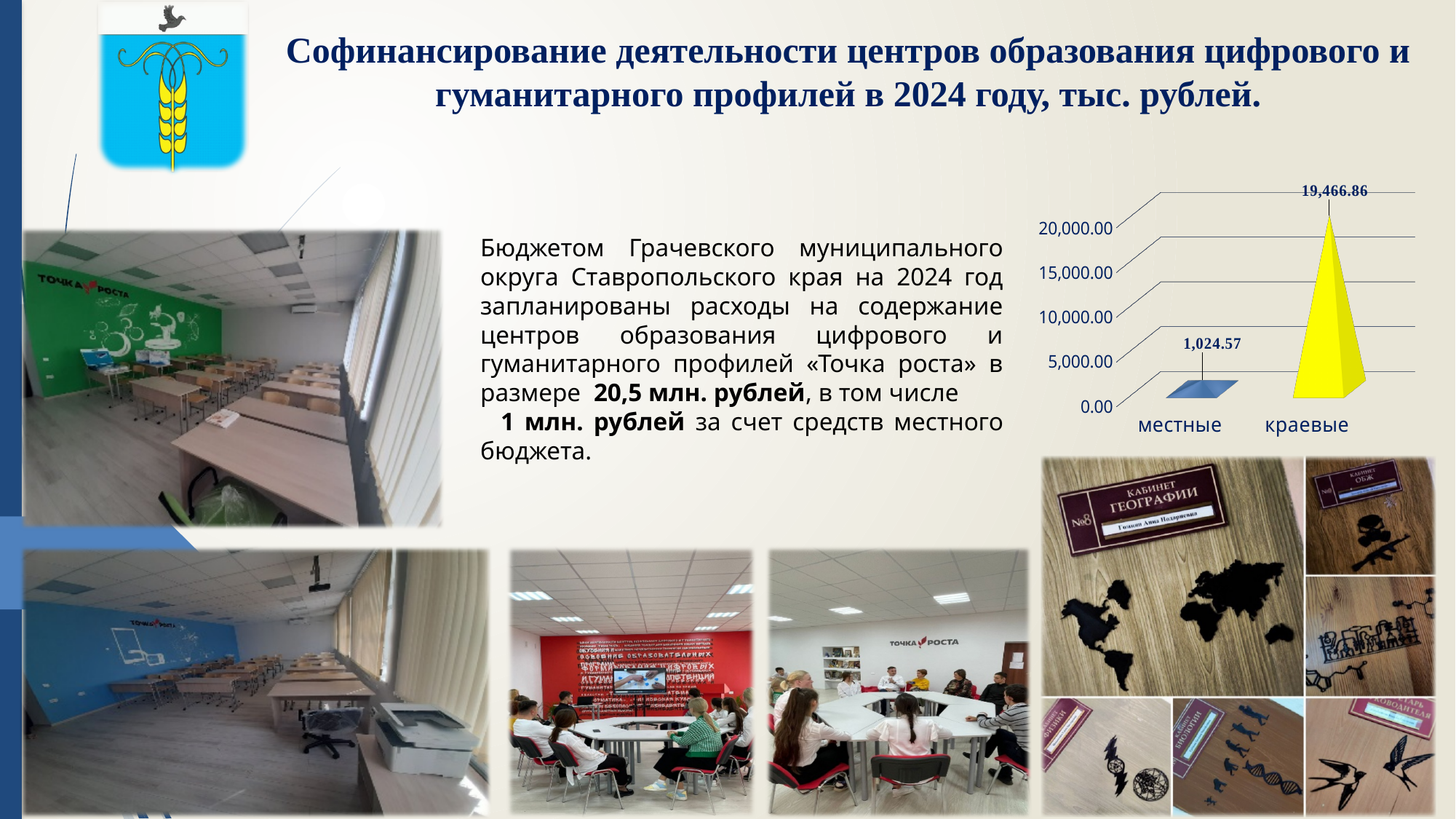
Which category has the lowest value in the chart? местные What colour is the bar for краевые? yellow What is the value for местные in the chart? 1,024.57 Which is larger, the value for местные or the value for краевые? краевые What kind of chart is shown on the slide? bar chart What is the highest value shown on the chart's vertical axis? 20,000.00 How many categories are shown in the chart? 2 Which category has the highest value in the chart? краевые What is the difference between the values for краевые and местные? 18,442.29 Is the value for местные greater or less than 5,000.00? less Is the value for краевые greater or less than 15,000.00? greater What is the value for краевые in the chart? 19,466.86